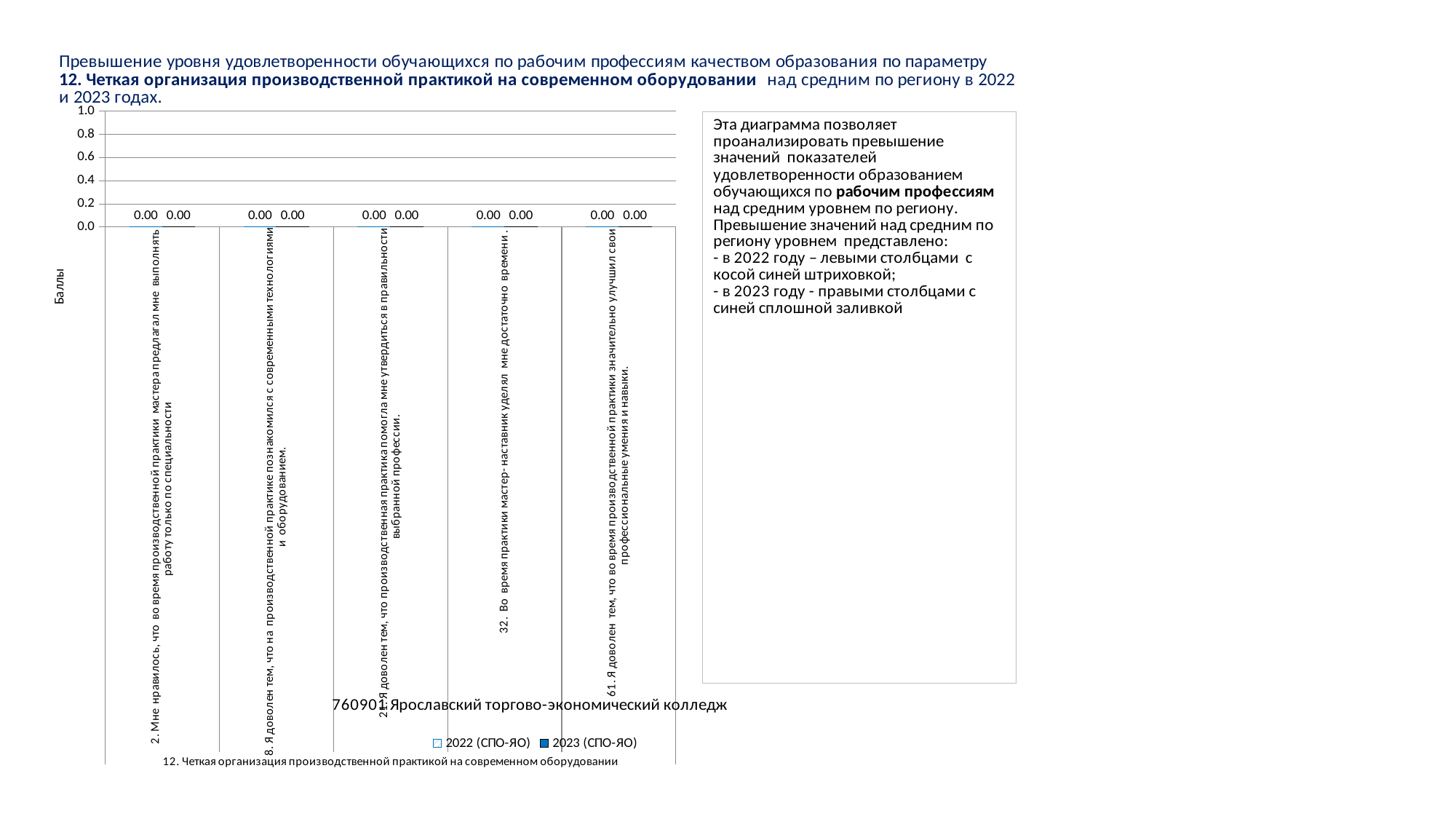
What is the label of the chart's vertical axis? Баллы What is the value for 2023 (СПО-ЯО) for statement 32 ("Во время практики мастер-наставник уделял мне достаточно времени")? 0.00 Is the value for 2023 (СПО-ЯО) for statement 2 greater or less than 0.2? less What kind of chart is shown on the slide? Bar chart What is the value for 2022 (СПО-ЯО) for statement 2 ("Мне нравилось, что во время производственной практики мастер предлагал мне выполнять работу только по специальности")? 0.00 How many categories (statements) are plotted along the x axis of the chart? 5 What are the two series names listed in the chart legend? 2022 (СПО-ЯО) and 2023 (СПО-ЯО) What is the value for 2022 (СПО-ЯО) for statement 21 ("Я доволен тем, что производственная практика помогла мне утвердиться в правильности выбранной профессии")? 0.00 What is the difference between the 2022 (СПО-ЯО) and 2023 (СПО-ЯО) values for statement 32? 0.00 What is the value for 2023 (СПО-ЯО) for statement 8 ("Я доволен тем, что на производственной практике познакомился с современными технологиями и оборудованием")? 0.00 How many series does the chart legend list? 2 What is the value for 2022 (СПО-ЯО) for statement 61 ("Я доволен тем, что во время производственной практики значительно улучшил свои профессиональные умения и навыки")? 0.00